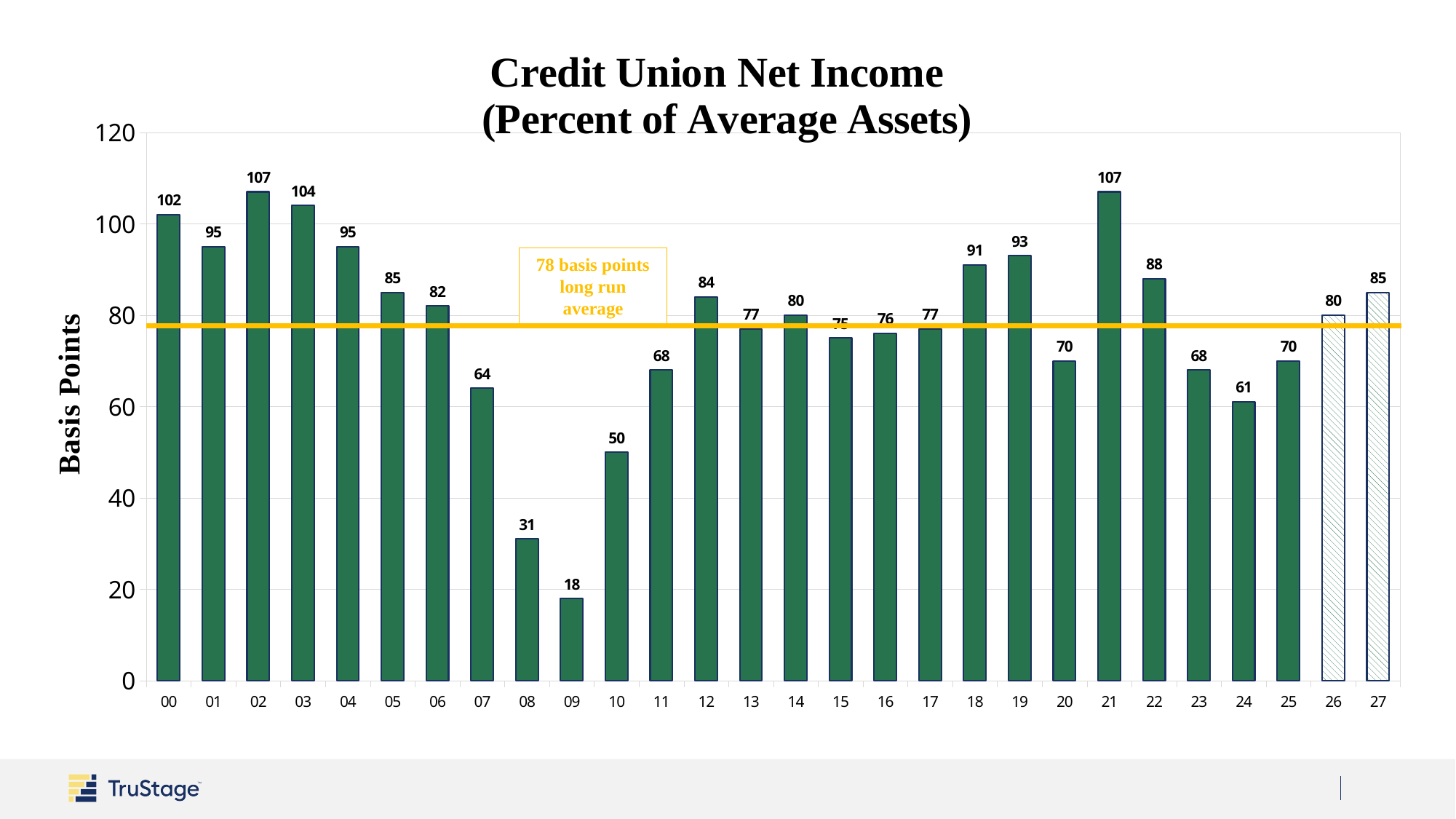
What is the value for 27? 85 What is the value for 21? 107 What is the value for 09? 18 What is the difference between the values for 08 and 09? 13 Which is larger, the value for 10 or the value for 11? 11 Which year has the lowest value? 09 Which is larger, the value for 18 or the value for 19? 19 What long run average does the horizontal line mark? 78 basis points What is the difference between the values for 22 and 23? 20 How many years are shown on the x axis? 28 What kind of chart is this? bar chart Is the value for 24 greater or less than 80? less